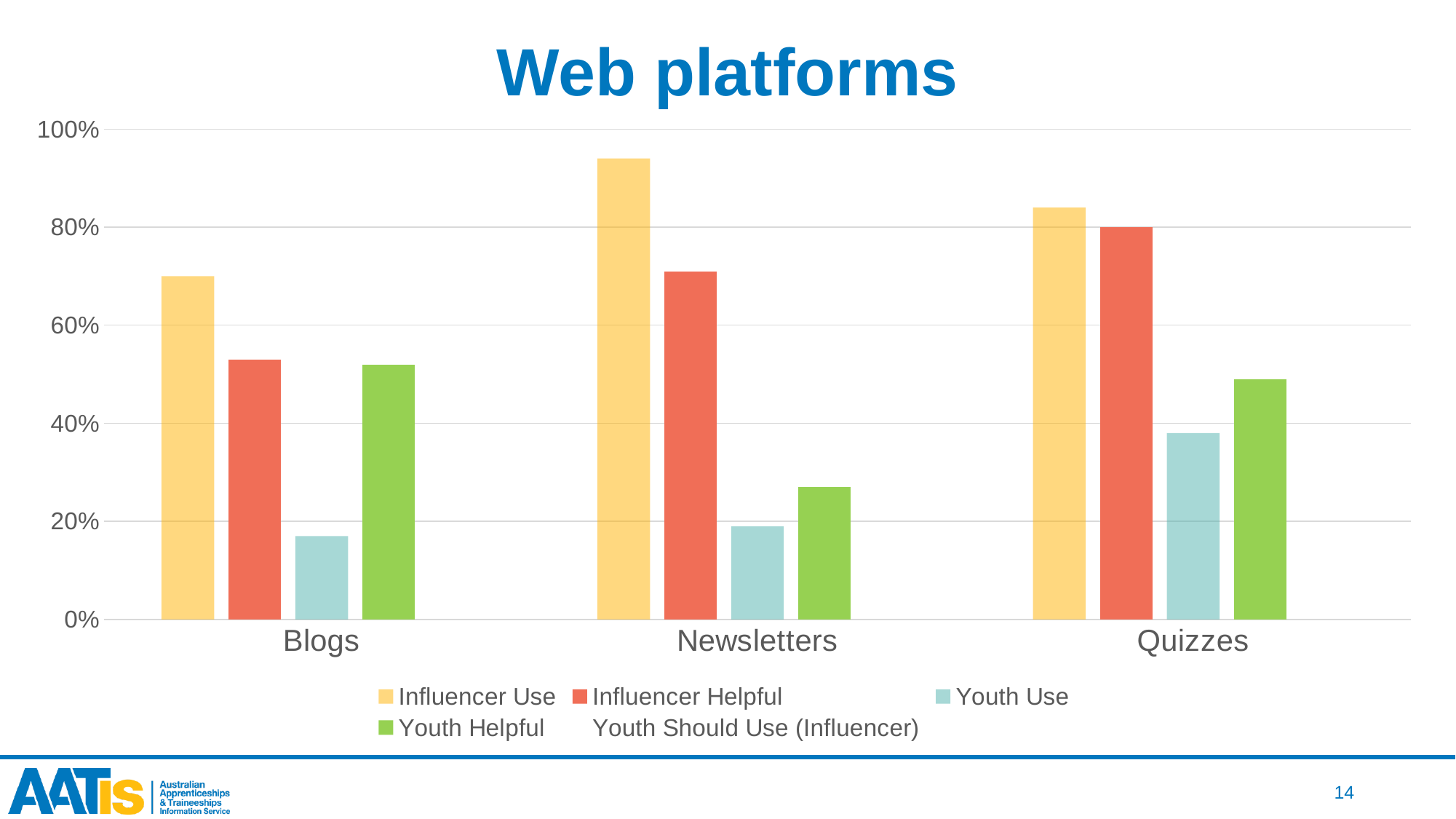
Which category has the highest Influencer Helpful value? Quizzes Which category has the highest Influencer Use value? Newsletters How many categories are shown on the x axis? 3 Is the Youth Helpful value for Newsletters greater or less than 40%? less Is the Influencer Use value for Newsletters greater or less than 80%? greater How many series does the legend list? 5 Which is larger: the Influencer Use value for Blogs or for Quizzes? Quizzes What is the title of the chart? Web platforms Which category has the lowest Youth Helpful value? Newsletters Is the Youth Use value for Quizzes greater or less than 20%? greater What kind of chart is shown on the slide? bar chart For Quizzes, which is larger: Influencer Helpful or Youth Helpful? Influencer Helpful